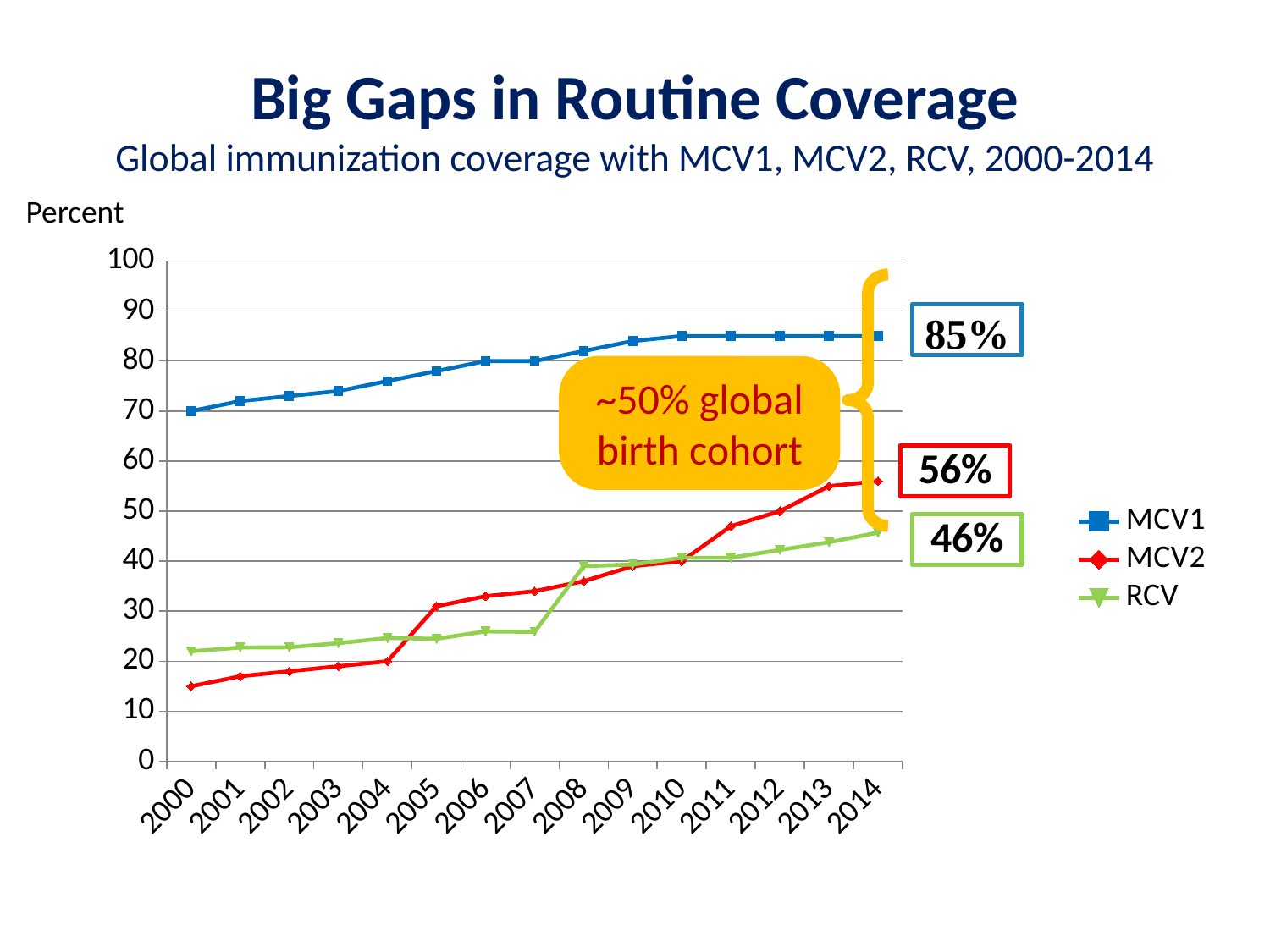
Which series has the lowest value in 2014? RCV What is the RCV coverage value labelled for 2014? 46% What type of chart is shown on the slide? line chart How many series does the legend list? 3 What is the MCV1 coverage value labelled for 2014? 85% What is the MCV2 coverage value labelled for 2014? 56% Does the MCV2 series rise or fall from 2000 to 2014? rise Is the MCV2 value for 2000 greater or less than 20? less How many years are shown on the x axis? 15 Which series has the highest value in 2014? MCV1 Is the RCV value for 2008 greater or less than 30? greater What is the difference between the 2014 MCV1 and MCV2 values? 29%